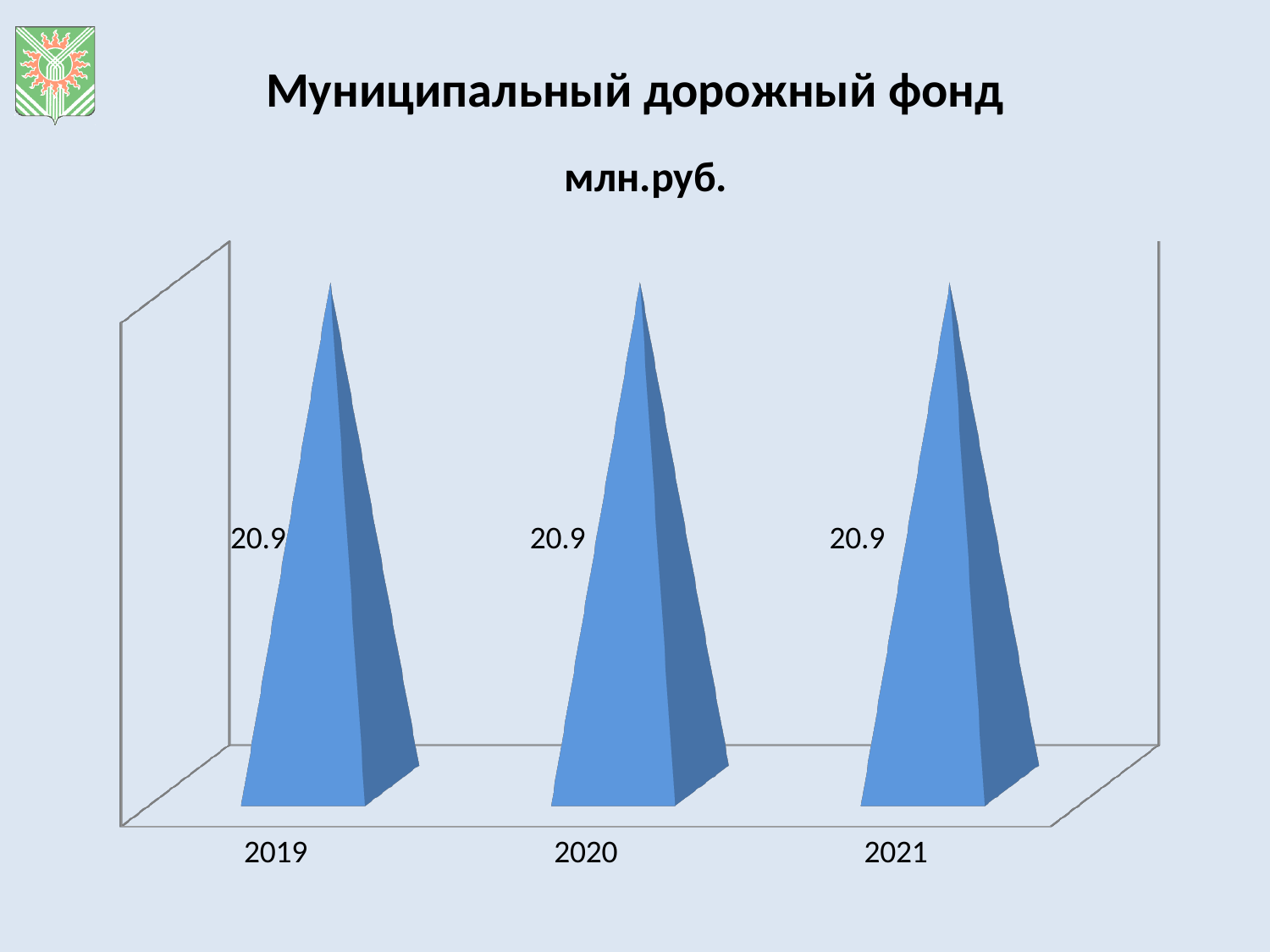
What is the total of the values for 2019, 2020 and 2021? 62.7 What kind of chart is shown on the slide? Bar chart How many categories are shown on the x axis? 3 Do the values rise, fall or stay the same from 2019 to 2021? Stay the same What is the value for 2021? 20.9 What is the value for 2019? 20.9 What is the title of the chart? млн.руб. In what units are the values on the chart given? млн.руб. What is the value for 2020? 20.9 What is the difference between the values for 2021 and 2019? 0 What is the difference between the values for 2020 and 2019? 0 Which years are shown as categories on the chart? 2019, 2020, 2021